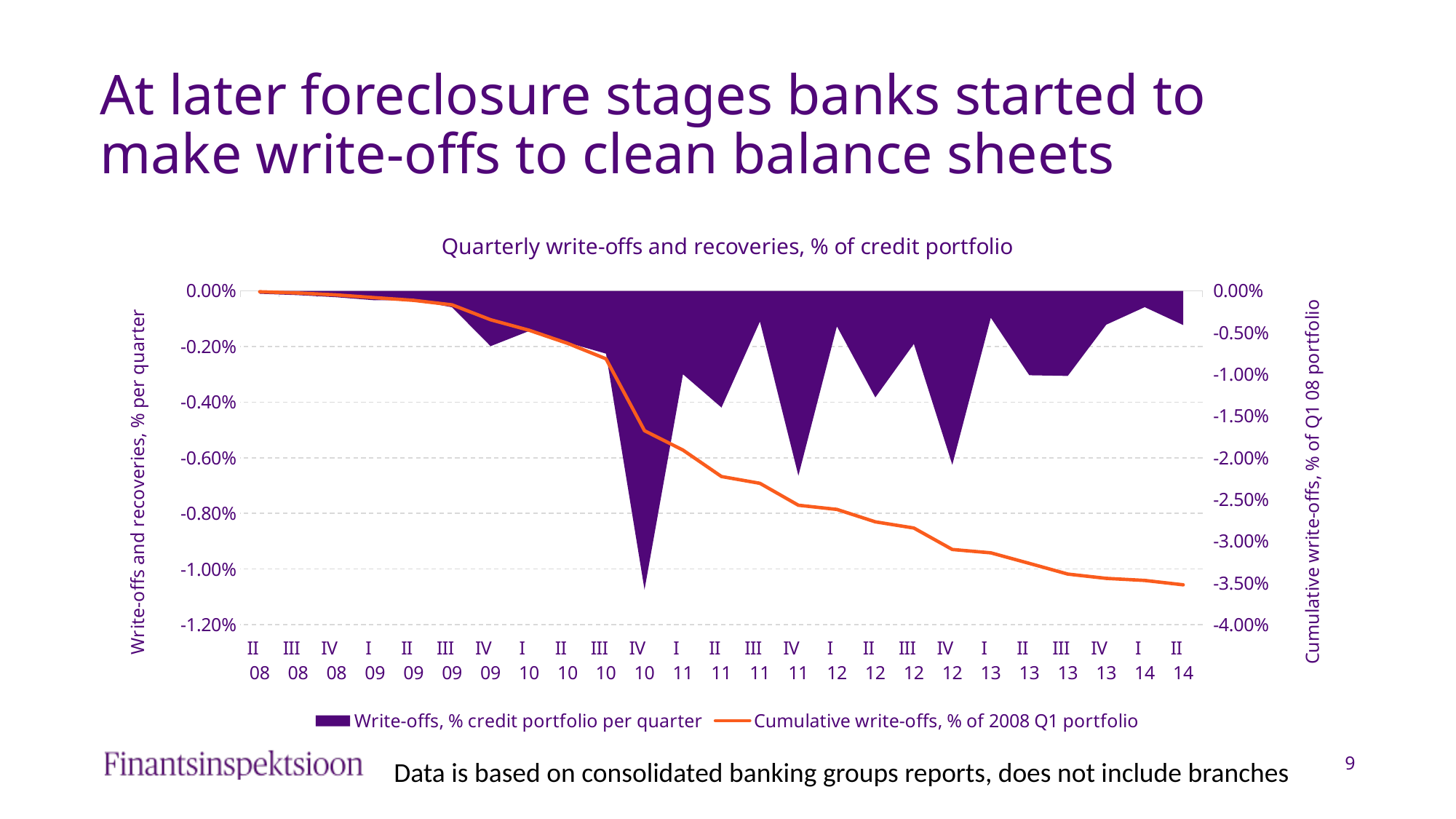
How many series does the legend list? 2 How many quarters are shown on the x axis? 25 Is the cumulative write-off value for II 14 greater or less than -3.00%? less Is the quarterly write-off value for I 14 greater or less than -0.20%? greater Does the cumulative write-offs line rise or fall along the x axis? It falls Is the cumulative write-off value for IV 10 greater or less than -1.00%? less What is the title of the chart? Quarterly write-offs and recoveries, % of credit portfolio What kind of chart is shown on the slide? An area chart combined with a line chart In which quarter is the quarterly write-off value the lowest (most negative)? IV 10 Which quarter shows the larger (more negative) quarterly write-off, IV 10 or IV 12? IV 10